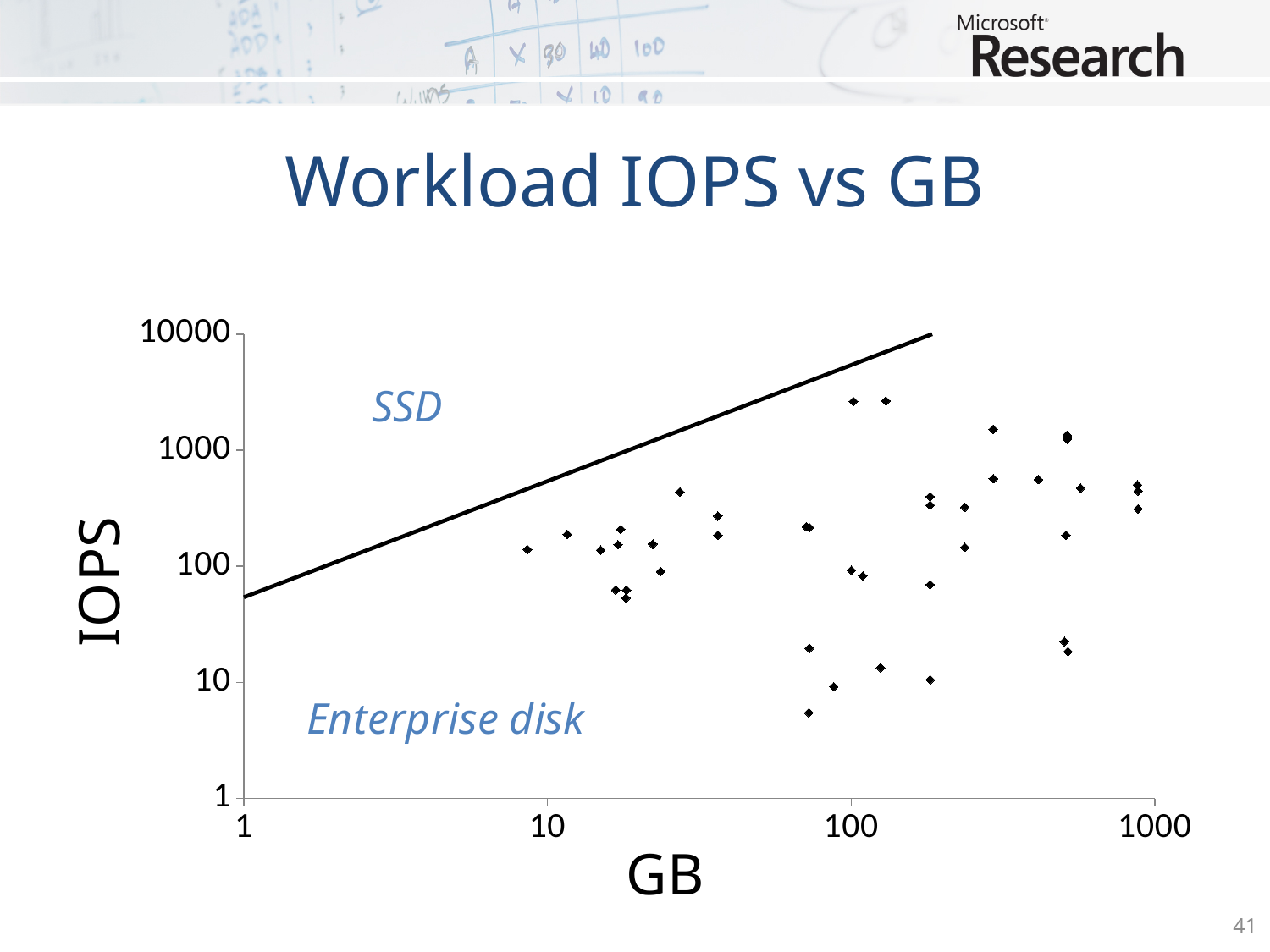
Does the diagonal line rise or fall as GB increases along the x axis? rises Is the highest plotted IOPS value greater or less than 10000? less Is the lowest plotted IOPS value greater or less than 10? less What is the title of the chart? Workload IOPS vs GB Which region label appears above the diagonal line and which below it? SSD above, Enterprise disk below Is the smallest plotted GB value greater or less than 10? less How many tick labels are shown on the x axis? 4 Do any of the plotted points lie above the diagonal line, in the SSD region? No What kind of chart is shown on the slide? scatter plot What is the highest tick value shown on the IOPS axis? 10000